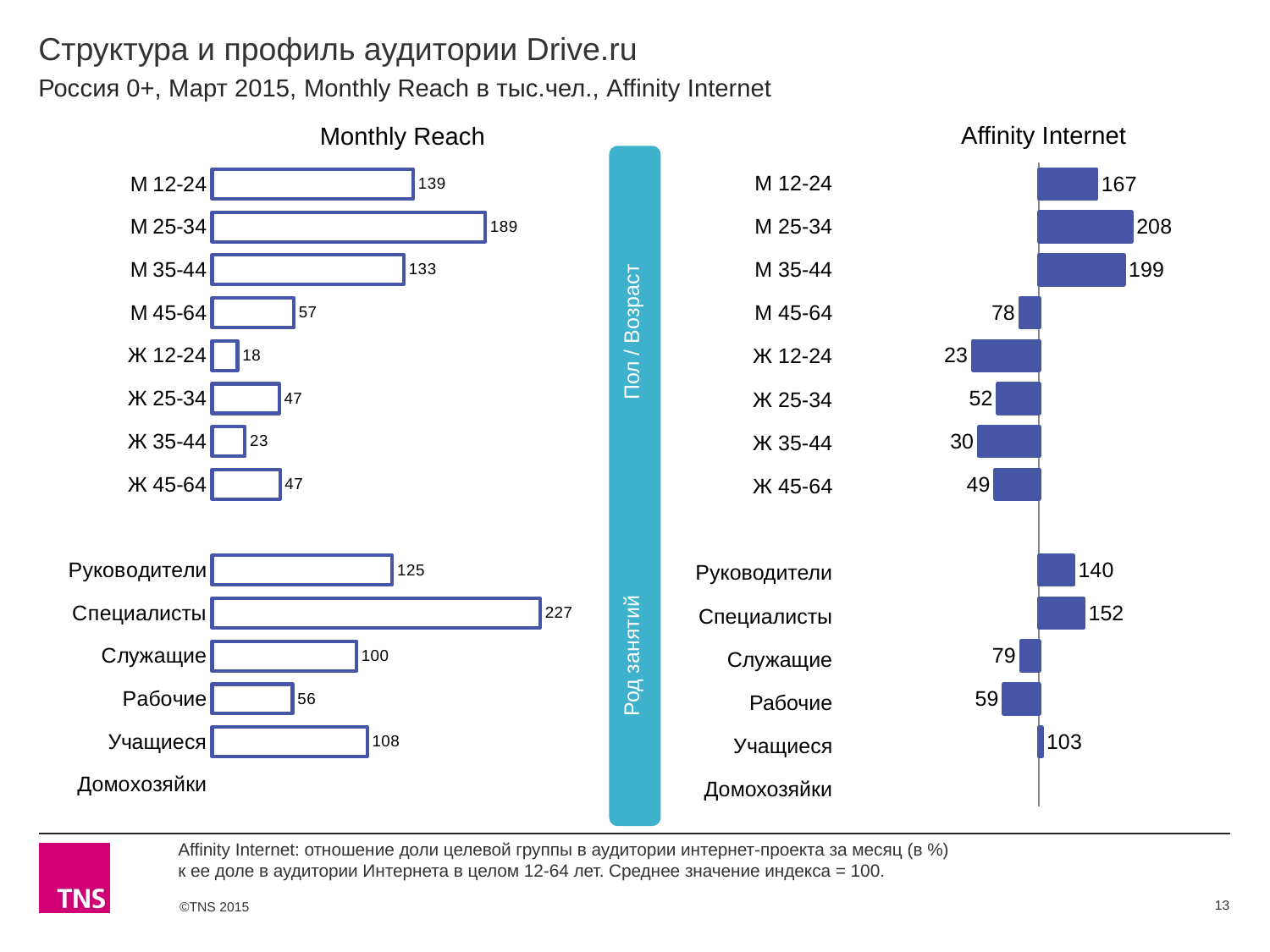
In the Monthly Reach chart, which is larger, М 12-24 or М 35-44? М 12-24 In the Affinity Internet chart, which is larger, Руководители or Специалисты? Специалисты In the Monthly Reach chart, what is the value for Служащие? 100 In the Affinity Internet chart, what is the difference between М 12-24 and М 45-64? 89 In the Affinity Internet chart, what is the value for Ж 35-44? 30 In the Affinity Internet chart, which category has the lowest labelled value? Ж 12-24 What type of chart is the Affinity Internet chart? Bar chart In the Monthly Reach chart, what is the difference between Специалисты and Руководители? 102 In the Monthly Reach chart, which category has the lowest labelled value? Ж 12-24 In the Monthly Reach chart, what is the value for М 25-34? 189 In the Monthly Reach chart, which category has the highest value? Специалисты In the Affinity Internet chart, which category has the highest value? М 25-34